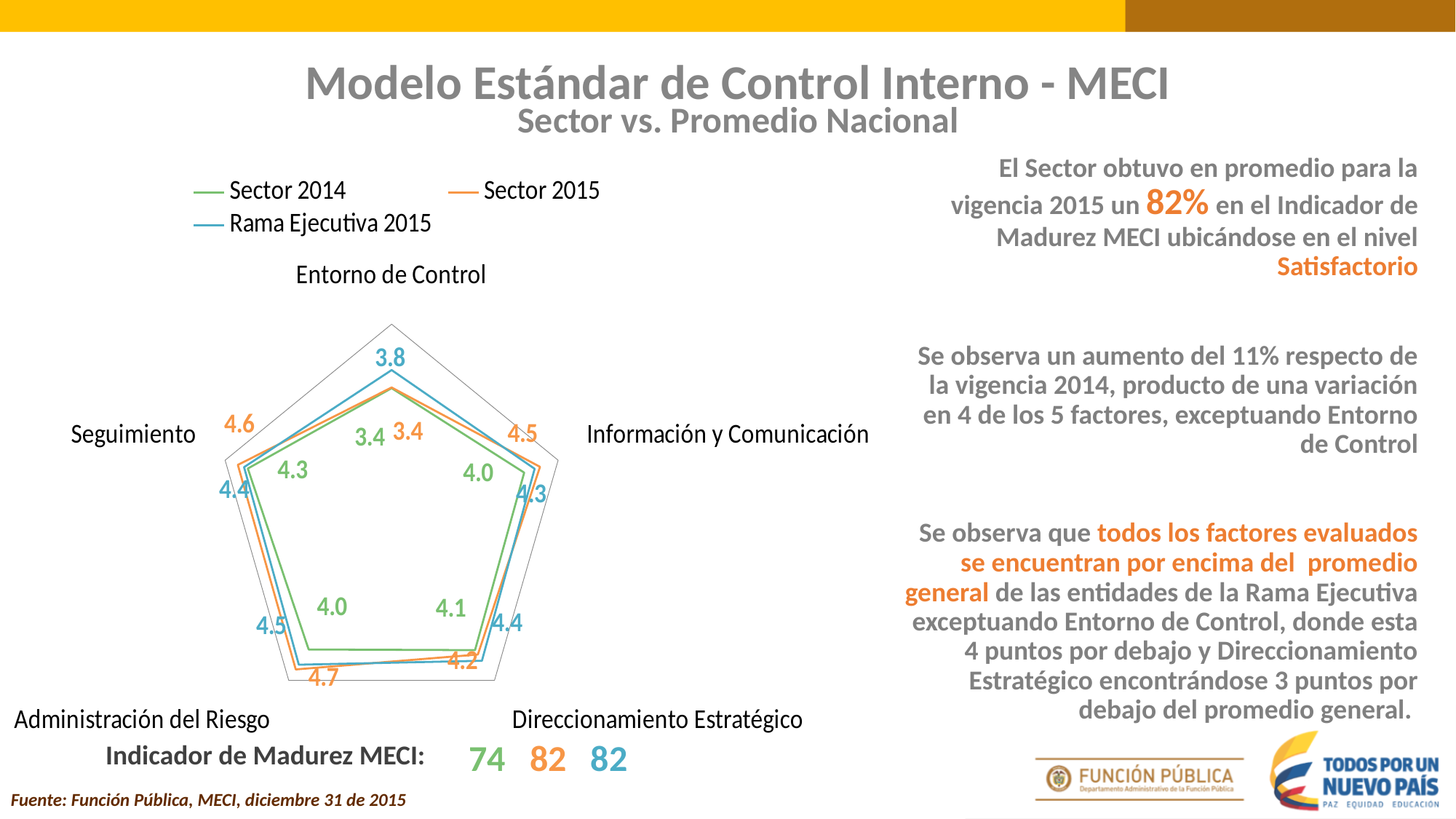
Which factor has the highest Sector 2015 value? Administración del Riesgo What is the difference between the Sector 2015 and Sector 2014 values for Administración del Riesgo? 0.7 Which factor has the lowest Rama Ejecutiva 2015 value? Entorno de Control For Direccionamiento Estratégico, which is larger: the Sector 2015 value or the Rama Ejecutiva 2015 value? Rama Ejecutiva 2015 What is the Sector 2015 value for Administración del Riesgo? 4.7 How many factors (categories) are plotted on the radar chart? 5 What is the Sector 2014 value for Información y Comunicación? 4.0 What is the Rama Ejecutiva 2015 value for Entorno de Control? 3.8 What is the Sector 2015 value for Seguimiento? 4.6 What kind of chart is shown on the slide? Radar chart Which series is drawn in green on the chart? Sector 2014 How many series does the chart legend list? 3